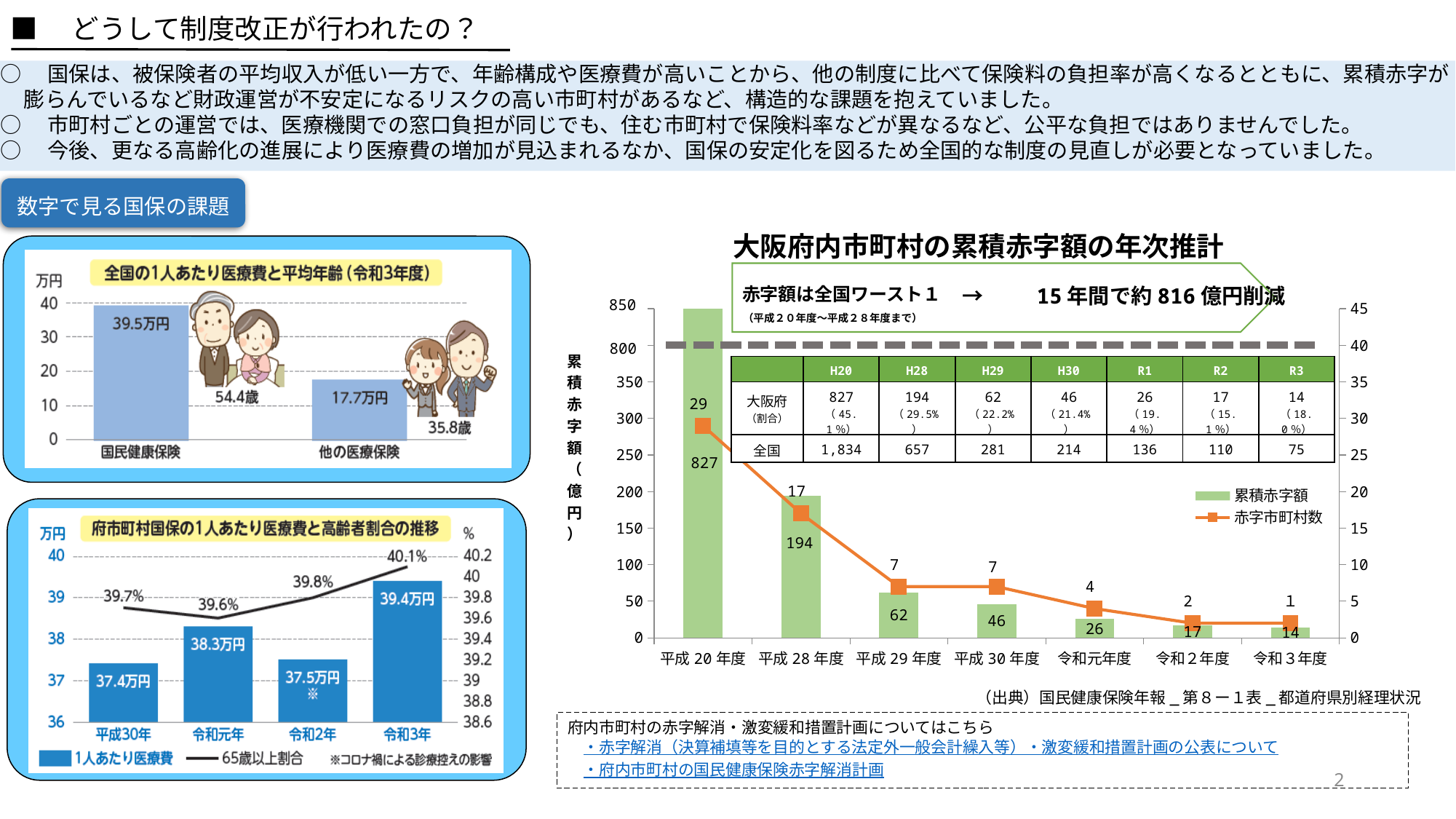
In the top-left chart titled 全国の1人あたり医療費と平均年齢（令和3年度）, what is the value for 国民健康保険? 39.5万円 In the bottom-left chart titled 府市町村国保の1人あたり医療費と高齢者割合の推移, what is the 1人あたり医療費 for 令和3年? 39.4万円 In the chart titled 大阪府内市町村の累積赤字額の年次推計, what is the 累積赤字額 value for 平成20年度? 827 In the chart titled 大阪府内市町村の累積赤字額の年次推計, which series is drawn as a line with square markers? 赤字市町村数 In the bottom-left chart titled 府市町村国保の1人あたり医療費と高齢者割合の推移, what is the 65歳以上割合 for 令和2年? 39.8% In the chart titled 大阪府内市町村の累積赤字額の年次推計, which year has the lowest 累積赤字額? 令和3年度 In the chart titled 大阪府内市町村の累積赤字額の年次推計, how many series does the legend list? 2 In the chart titled 大阪府内市町村の累積赤字額の年次推計, what is the 赤字市町村数 value for 令和元年度? 4 In the chart titled 大阪府内市町村の累積赤字額の年次推計, does the 累積赤字額 rise or fall from 平成20年度 to 令和3年度? fall In the chart titled 大阪府内市町村の累積赤字額の年次推計, how many years are shown on the x axis? 7 In the top-left chart titled 全国の1人あたり医療費と平均年齢（令和3年度）, which is larger, 国民健康保険 or 他の医療保険? 国民健康保険 In the chart titled 大阪府内市町村の累積赤字額の年次推計, what is the difference in 累積赤字額 between 平成28年度 and 平成29年度? 132